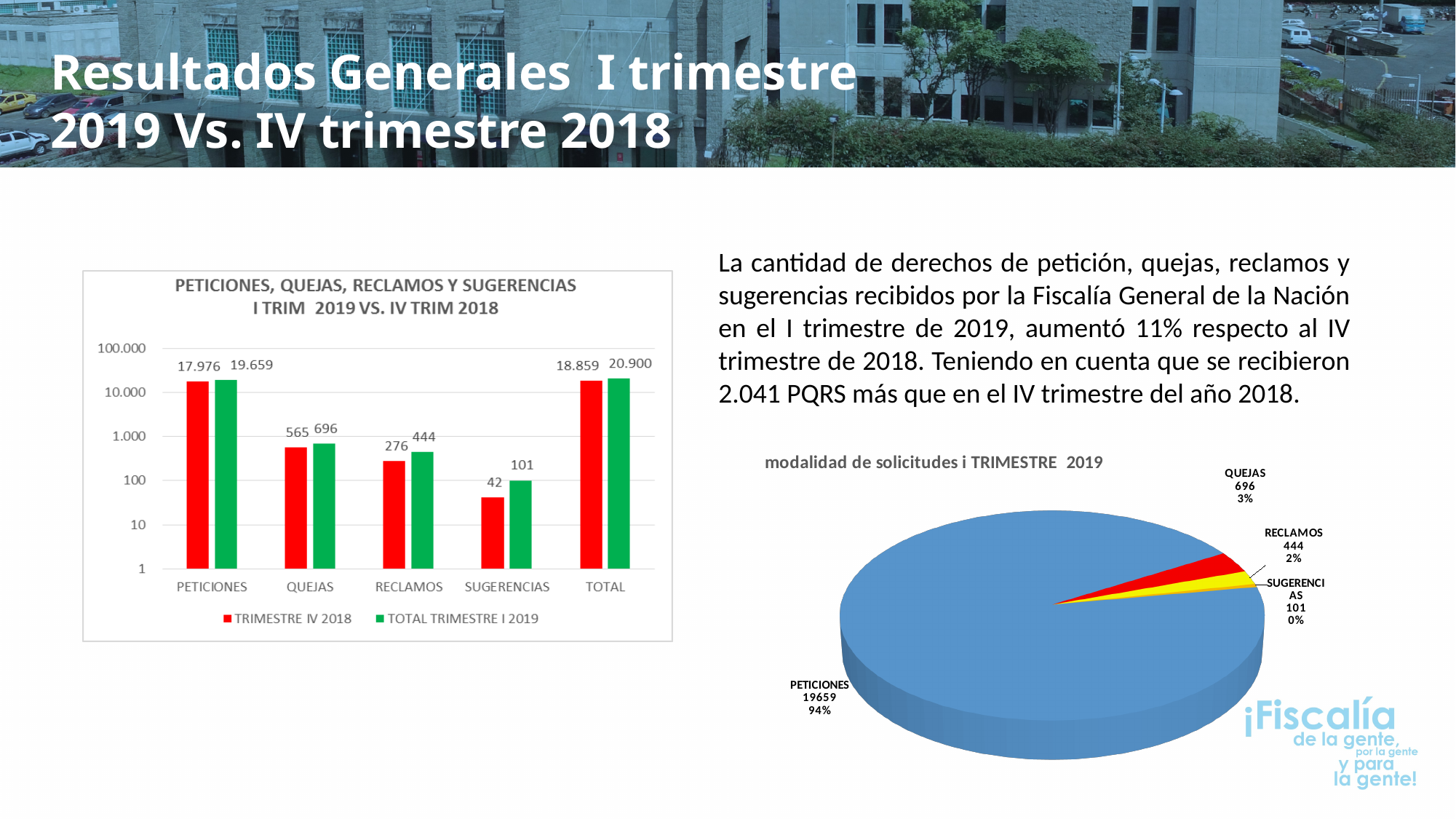
In the pie chart 'modalidad de solicitudes i TRIMESTRE 2019', what share does PETICIONES have? 94% In the bar chart 'PETICIONES, QUEJAS, RECLAMOS Y SUGERENCIAS', what is the value for RECLAMOS in TOTAL TRIMESTRE I 2019? 444 In the bar chart 'PETICIONES, QUEJAS, RECLAMOS Y SUGERENCIAS', which colour represents TRIMESTRE IV 2018? Red How many series does the legend of the bar chart 'PETICIONES, QUEJAS, RECLAMOS Y SUGERENCIAS' list? 2 In the bar chart 'PETICIONES, QUEJAS, RECLAMOS Y SUGERENCIAS', what is the value for QUEJAS in TRIMESTRE IV 2018? 565 In the bar chart 'PETICIONES, QUEJAS, RECLAMOS Y SUGERENCIAS', what is the difference between the SUGERENCIAS values for TOTAL TRIMESTRE I 2019 and TRIMESTRE IV 2018? 59 In the bar chart 'PETICIONES, QUEJAS, RECLAMOS Y SUGERENCIAS', which category has the lowest value for TRIMESTRE IV 2018? SUGERENCIAS How many categories are shown on the x axis of the bar chart 'PETICIONES, QUEJAS, RECLAMOS Y SUGERENCIAS'? 5 In the pie chart 'modalidad de solicitudes i TRIMESTRE 2019', what is the value for QUEJAS? 696 What kind of chart is the chart titled 'modalidad de solicitudes i TRIMESTRE 2019'? Pie chart In the bar chart 'PETICIONES, QUEJAS, RECLAMOS Y SUGERENCIAS', what is the TOTAL value for TRIMESTRE IV 2018? 18.859 In the bar chart 'PETICIONES, QUEJAS, RECLAMOS Y SUGERENCIAS', which is larger for PETICIONES: TRIMESTRE IV 2018 or TOTAL TRIMESTRE I 2019? TOTAL TRIMESTRE I 2019